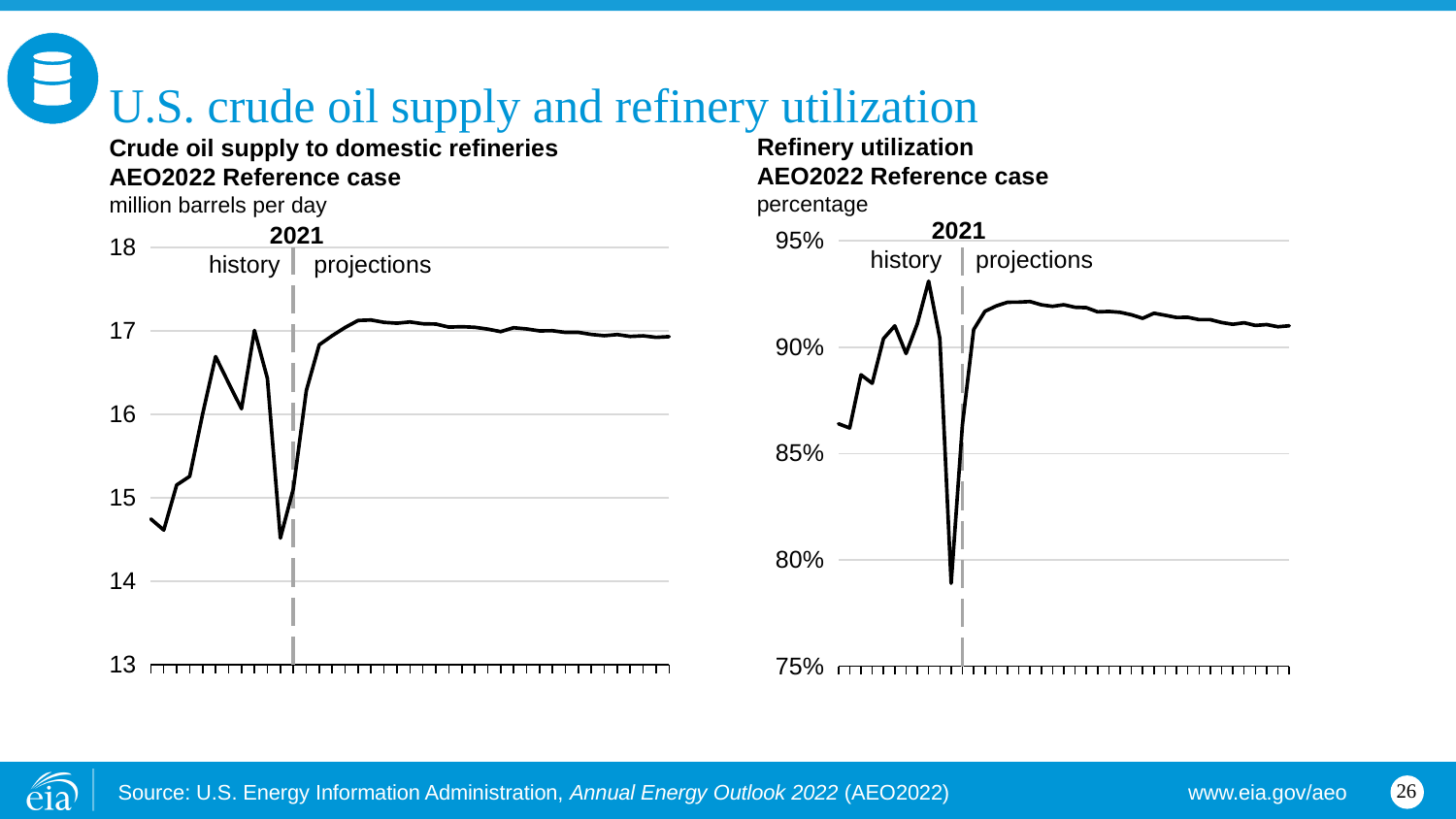
In the 'Crude oil supply to domestic refineries' chart, what unit is the vertical axis measured in? million barrels per day What kind of chart is the 'Refinery utilization' chart on the right? line chart In the 'Refinery utilization' chart, is the lowest value of the line (the dip just before the 2021 line) greater or less than 80%? less In the 'Refinery utilization' chart, after the initial recovery following 2021, does the line gradually rise or fall over the rest of the projections period? fall In the 'Refinery utilization' chart, are the values during the projections period greater or less than 95%? less In the 'Refinery utilization' chart, is the value at the start of the history period greater or less than 85%? greater In the 'Crude oil supply to domestic refineries' chart, does the line rise or fall immediately after the 2021 dashed line? rise In the 'Refinery utilization' chart, what year does the dashed vertical line separating history from projections mark? 2021 What kind of chart is the 'Crude oil supply to domestic refineries' chart on the left? line chart